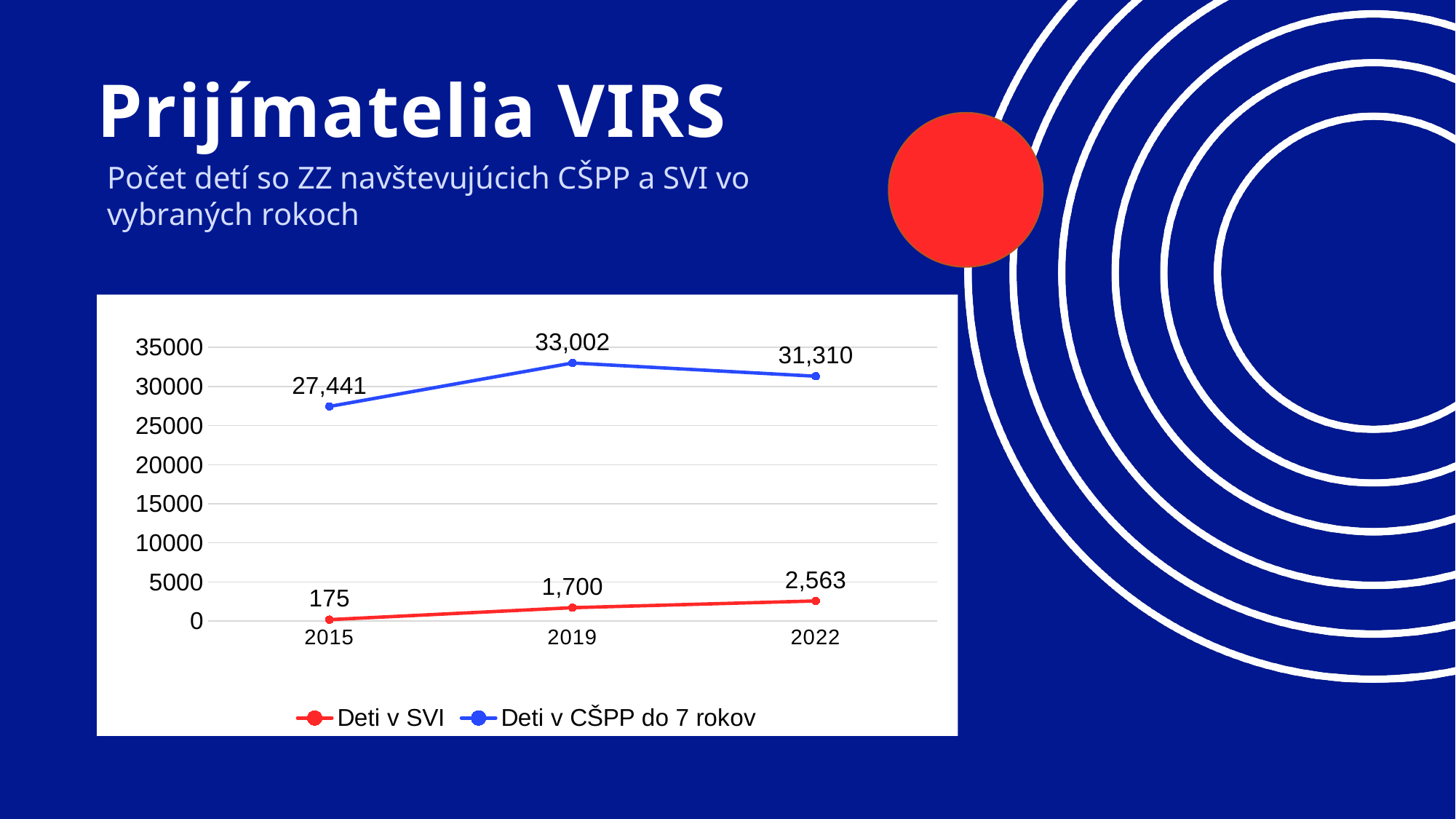
What is the value for Deti v SVI in 2022? 2,563 What is the value for Deti v SVI in 2015? 175 What is the difference between Deti v CŠPP do 7 rokov in 2019 and in 2015? 5,561 How many years are shown on the x axis? 3 In which year is the value for Deti v CŠPP do 7 rokov highest? 2019 In which year is the value for Deti v SVI lowest? 2015 How many series does the legend list? 2 What is the value for Deti v CŠPP do 7 rokov in 2022? 31,310 What is the difference between Deti v SVI in 2022 and in 2019? 863 What kind of chart is shown on the slide? Line chart Which is larger: Deti v CŠPP do 7 rokov in 2015 or in 2022? 2022 What is the value for Deti v CŠPP do 7 rokov in 2019? 33,002